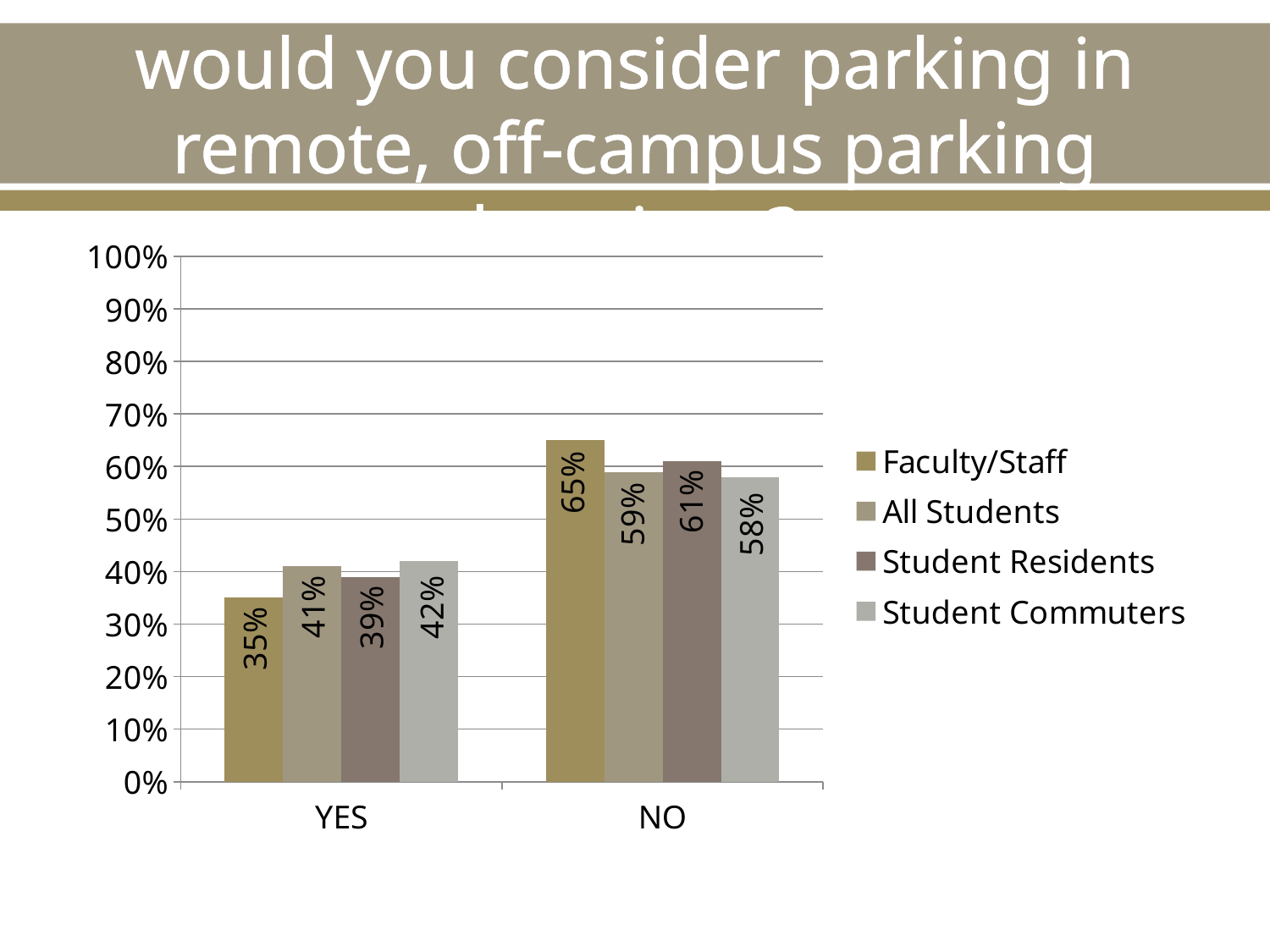
Which group has the highest value in the NO category? Faculty/Staff What percentage of Faculty/Staff answered YES? 35% What is the value for All Students in the YES category? 41% Which is larger: the Student Commuters YES value or the Student Residents YES value? Student Commuters What percentage of Student Commuters answered NO? 58% What is the value for Student Residents in the NO category? 61% What is the difference between the Faculty/Staff NO value and the Faculty/Staff YES value? 30% Which group has the lowest value in the YES category? Faculty/Staff What kind of chart is shown on the slide? Bar chart What is the total of the All Students YES and NO values? 100% How many series does the legend list? 4 How many categories are shown on the x axis? 2